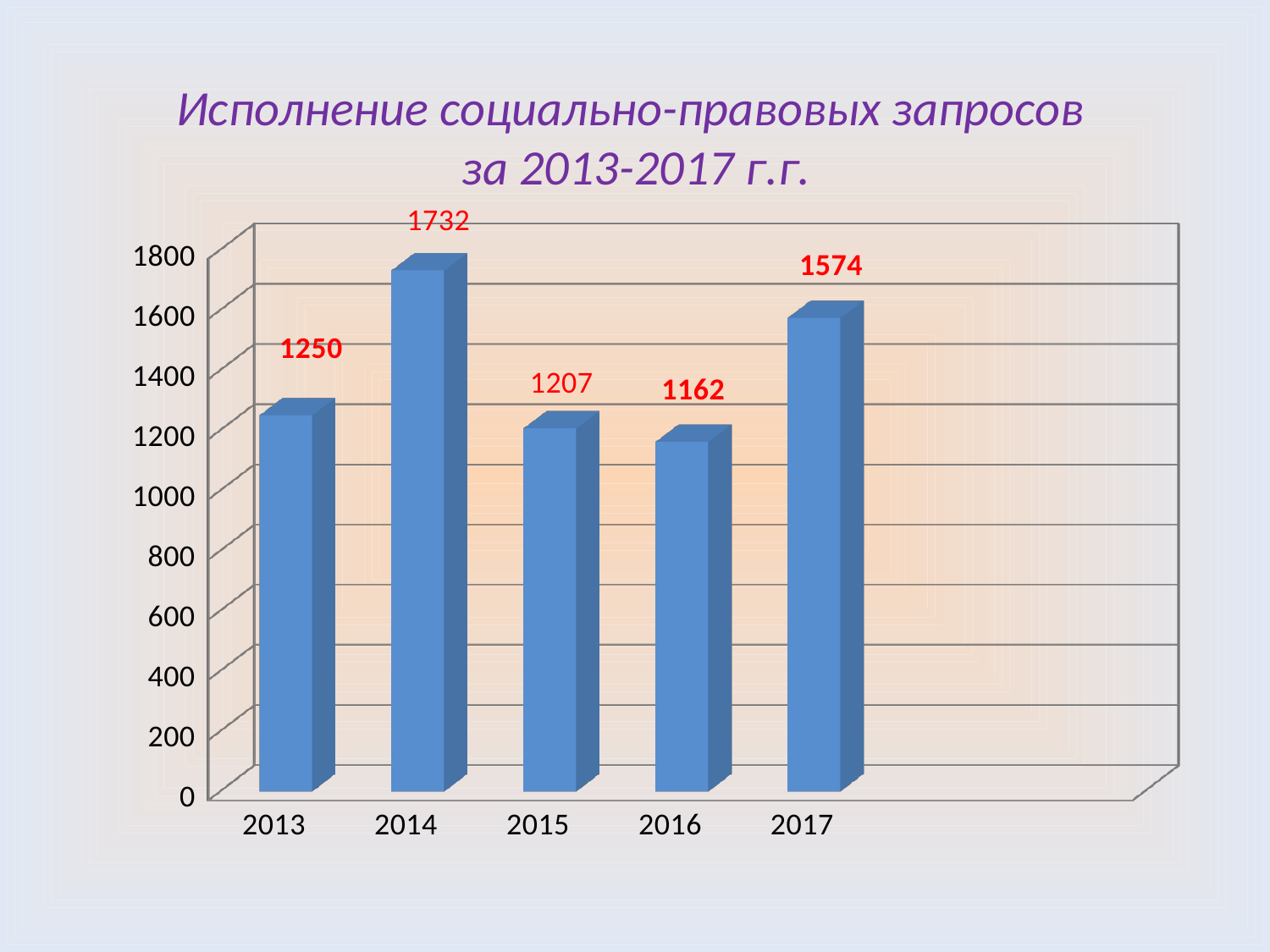
Which year has the lowest value? 2016 Which year has the highest value? 2014 Is the value for 2015 greater or less than 1400? less What is the value for 2017? 1574 What kind of chart is shown on the slide? bar chart What is the value for 2014? 1732 What is the title of the chart? Исполнение социально-правовых запросов за 2013-2017 г.г. What is the value for 2016? 1162 Which is larger, the value for 2013 or the value for 2017? 2017 How many years are shown on the x axis? 5 What is the difference between the values for 2013 and 2015? 43 What is the difference between the values for 2014 and 2017? 158